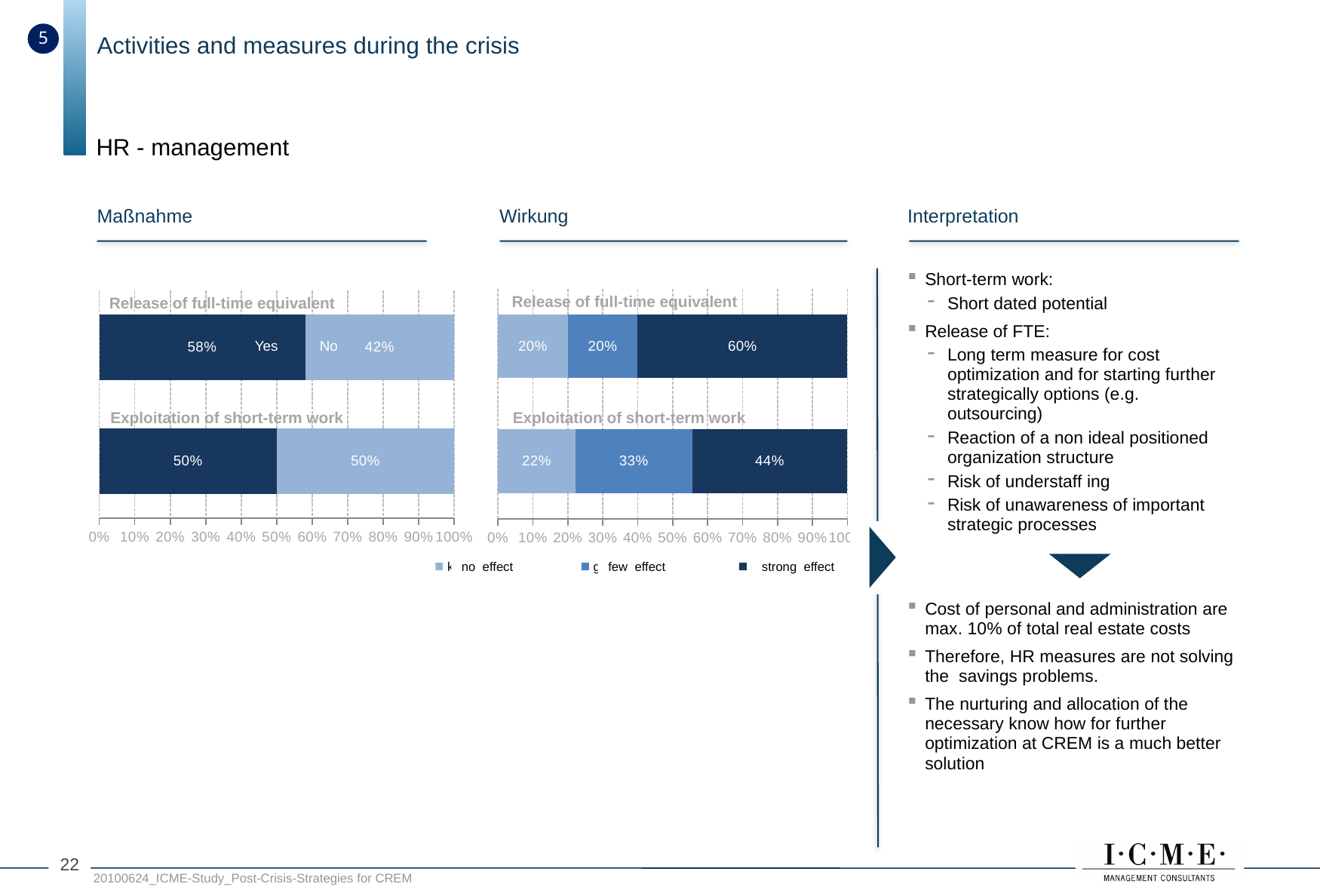
In the Maßnahme chart, what percentage answered No for Release of full-time equivalent? 42% In the Maßnahme chart, what is the difference between the Yes and No shares for Release of full-time equivalent? 16% How many series does the legend of the Wirkung chart list? 3 In the Wirkung chart, what percentage reported no effect for Exploitation of short-term work? 22% In the Maßnahme chart, what percentage answered Yes for Release of full-time equivalent? 58% In the Wirkung chart, what percentage reported a strong effect for Release of full-time equivalent? 60% In the Wirkung chart, is the strong effect share larger for Release of full-time equivalent or for Exploitation of short-term work? Release of full-time equivalent In the Wirkung chart, what percentage reported a few effect for Exploitation of short-term work? 33% In the Wirkung chart, which effect category has the largest share for Release of full-time equivalent? strong effect What type of chart is the Wirkung chart? Stacked bar chart In the Maßnahme chart, what is the Yes share for Exploitation of short-term work? 50% In the Wirkung chart, what is the difference between the strong effect and no effect shares for Exploitation of short-term work? 22%